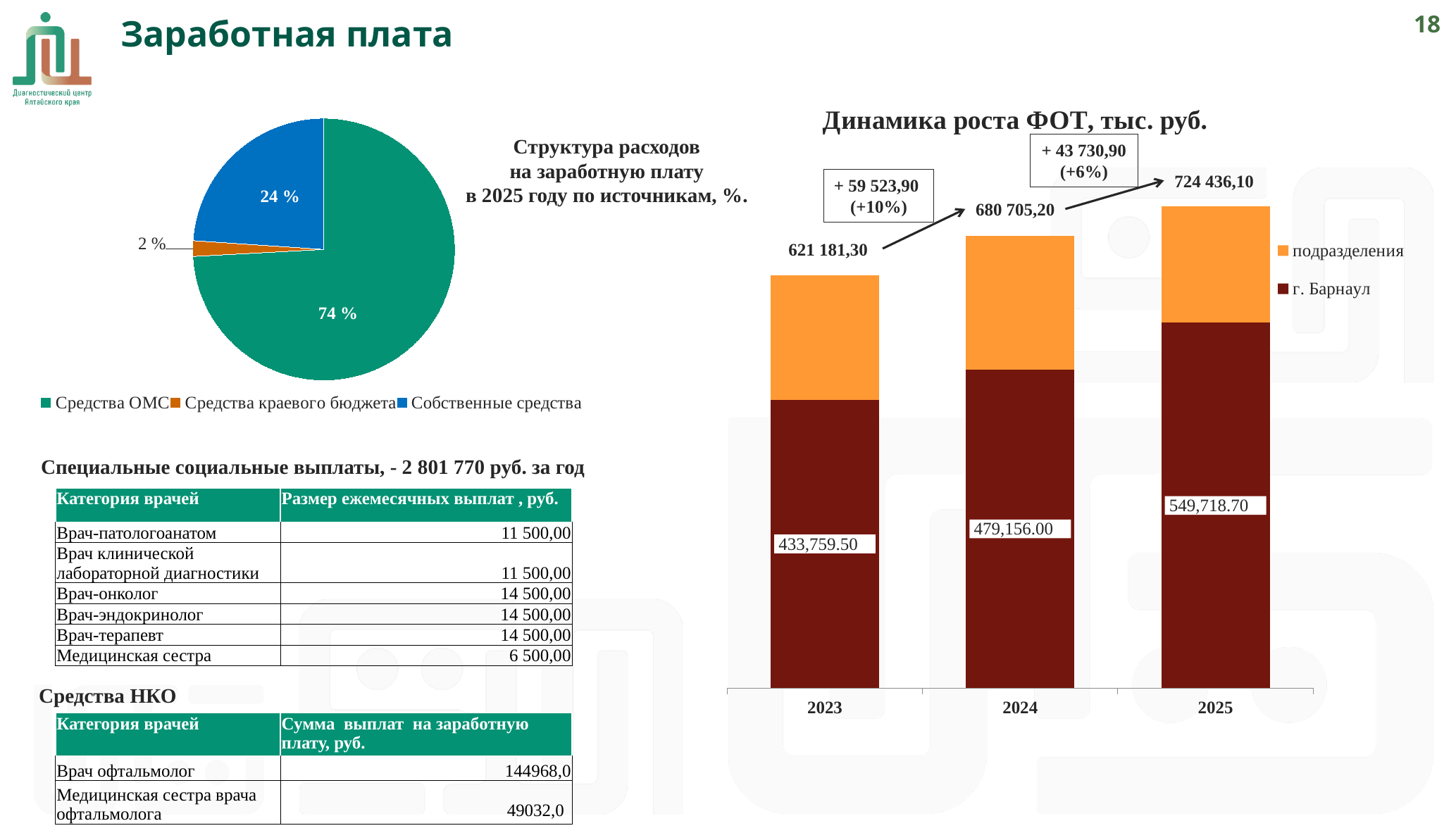
In the pie chart on the left, how many slices are there? 3 In the chart 'Динамика роста ФОТ, тыс. руб.', what is the total of the stacked bar for 2023? 621 181,30 In the chart 'Динамика роста ФОТ, тыс. руб.', what is the total of the stacked bar for 2025? 724 436,10 In the pie chart on the left, what share is Собственные средства? 24 % What kind of chart is 'Динамика роста ФОТ, тыс. руб.'? stacked bar chart In the chart 'Динамика роста ФОТ, тыс. руб.', how many series does the legend list? 2 In the pie chart on the left, which source has the smallest share? Средства краевого бюджета In the pie chart on the left, what is the difference in percentage points between Средства ОМС and Собственные средства? 50 In the chart 'Динамика роста ФОТ, тыс. руб.', do the total values rise or fall from 2023 to 2025? rise In the pie chart 'Структура расходов на заработную плату в 2025 году по источникам', what share is Средства ОМС? 74 % In the chart 'Динамика роста ФОТ, тыс. руб.', what is the value for г. Барнаул in 2024? 479,156.00 In the chart 'Динамика роста ФОТ, тыс. руб.', what is the difference between the г. Барнаул values for 2025 and 2023? 115,959.20